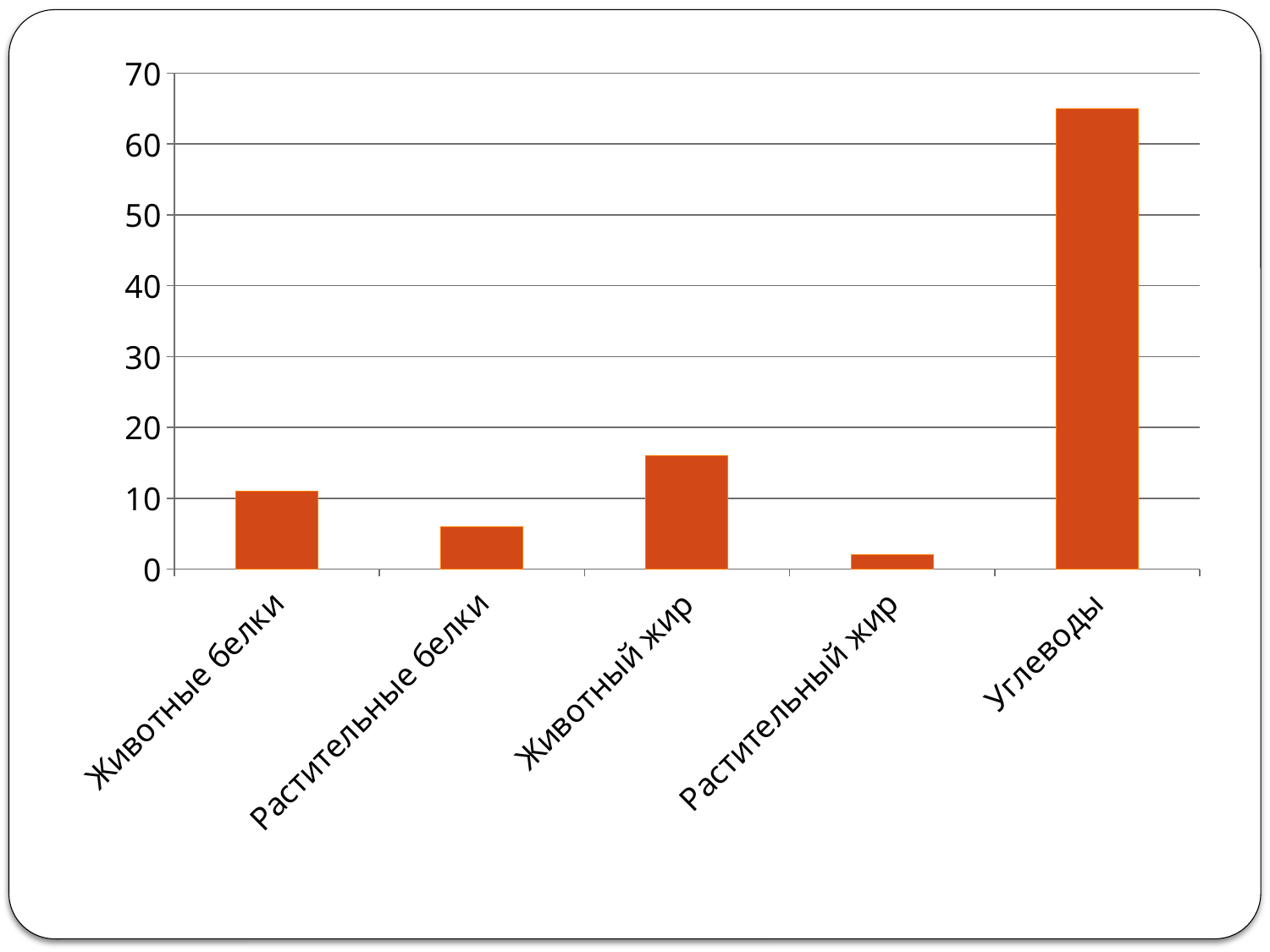
Which is larger, the value for Растительные белки or the value for Растительный жир? Растительные белки What colour are the bars in the chart? orange Is the value for Животный жир greater or less than 20? less What kind of chart is shown on the slide? bar chart Which category has the lowest value in the chart? Растительный жир How many categories are shown on the x axis of the chart? 5 Which category has the highest value in the chart? Углеводы Is the value for Растительные белки greater or less than 10? less Which is larger, the value for Животный жир or the value for Животные белки? Животный жир Is the value for Растительный жир greater or less than 10? less